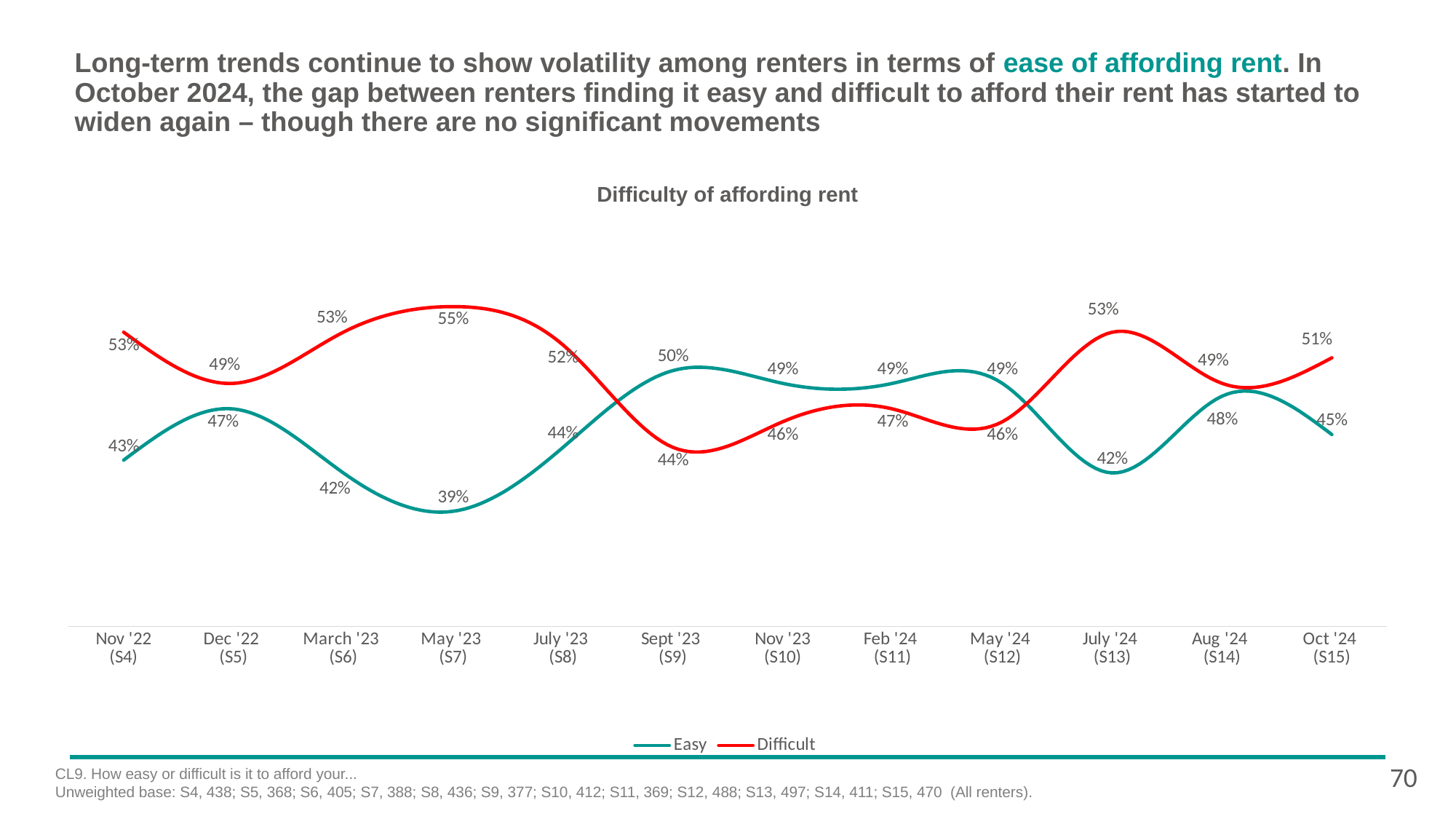
How does the Easy series change from Nov '22 (S4) to Dec '22 (S5)? It rises What is the title of the chart? Difficulty of affording rent In July '24 (S13), which is larger, Easy or Difficult? Difficult How many series does the legend list? 2 What type of chart is shown on the slide? Line chart What is the difference between Difficult and Easy in Oct '24 (S15)? 6 percentage points At which time point is the Difficult series highest? May '23 (S7) What is the value for Easy in Oct '24 (S15)? 45% What is the value for Easy in Sept '23 (S9)? 50% What is the value for Difficult in May '23 (S7)? 55% At which time point is the Easy series lowest? May '23 (S7) How many time points are shown on the x axis? 12